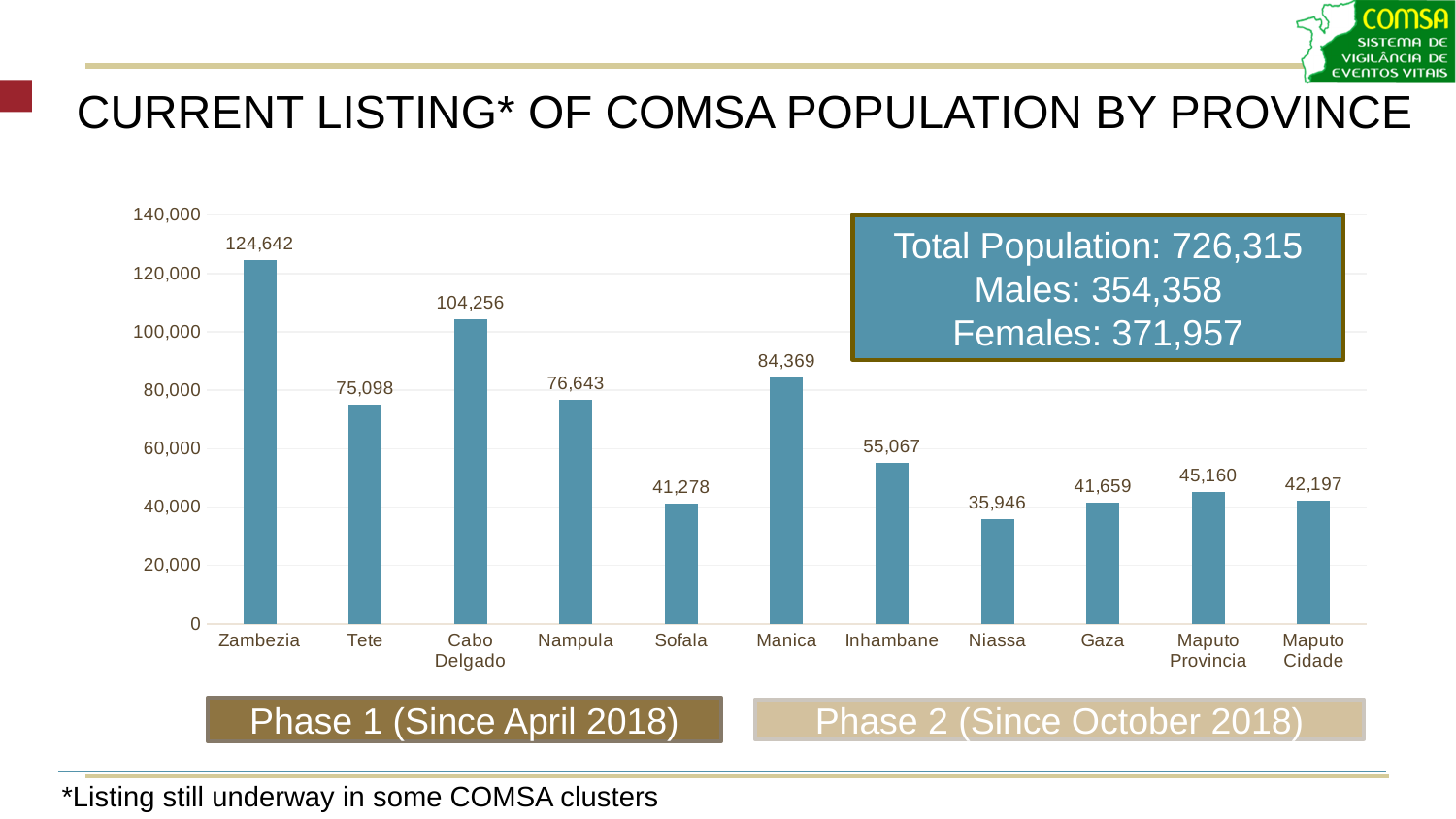
What is the listed population for Maputo Provincia? 45,160 What is the difference between the populations of Manica and Inhambane? 29,302 What is the listed population for Cabo Delgado? 104,256 What is the listed population for Inhambane? 55,067 Is the value for Manica greater or less than 80,000? greater What kind of chart is shown on the slide? Bar chart Which province has the lowest listed population? Niassa Which province has the highest listed population? Zambezia What is the difference between the populations of Zambezia and Cabo Delgado? 20,386 How many provinces are shown on the chart? 11 What is the listed population for Zambezia? 124,642 Which has a larger listed population, Maputo Provincia or Maputo Cidade? Maputo Provincia